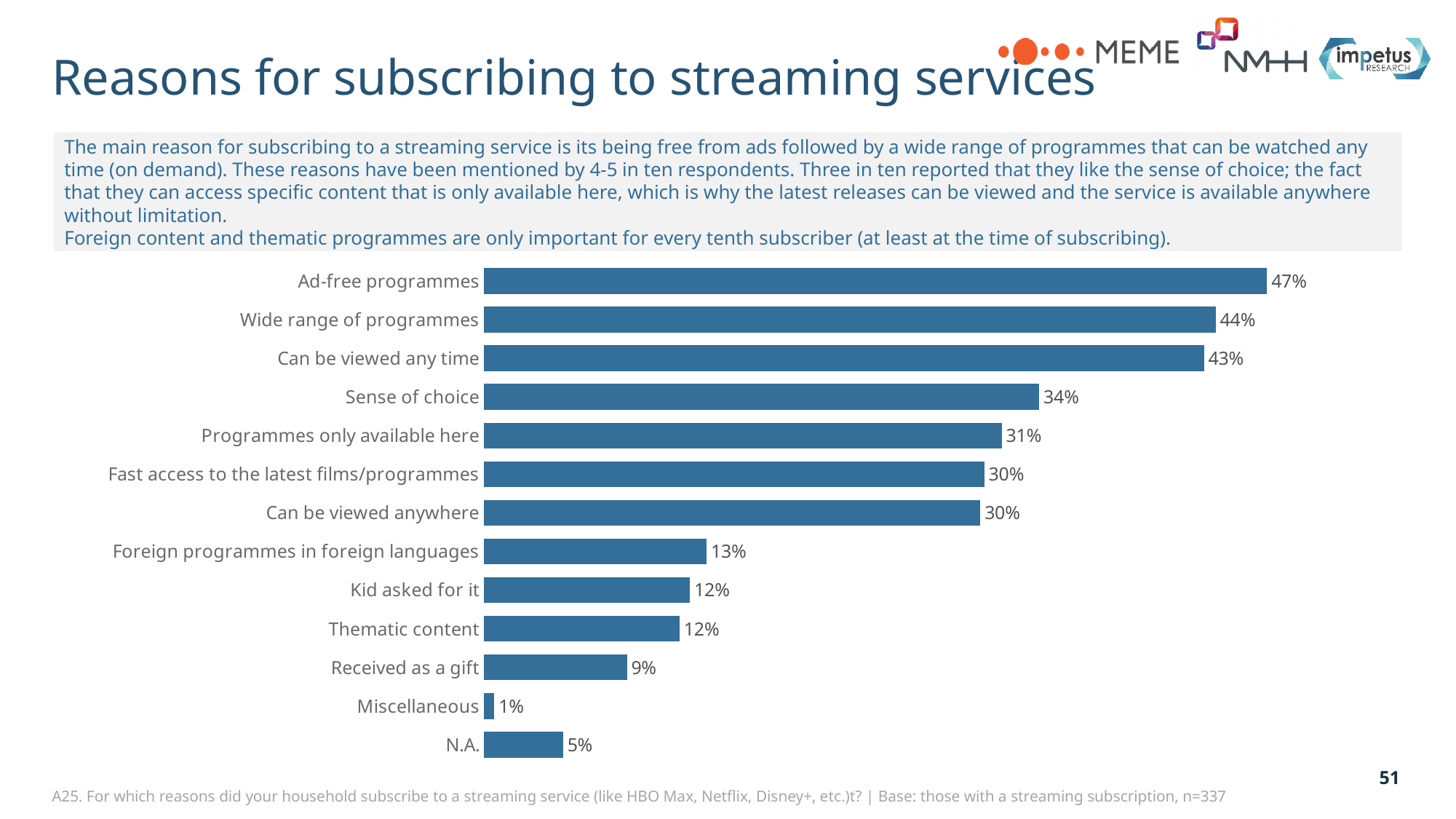
What is the base size (n) stated for the chart? n=337 Which reason has the highest percentage? Ad-free programmes Which is larger: 'Can be viewed any time' or 'Programmes only available here'? Can be viewed any time How many categories are shown in the chart? 13 What percentage is shown for 'Received as a gift'? 9% What is the difference between 'Ad-free programmes' and 'Wide range of programmes'? 3% What percentage of respondents cited 'Ad-free programmes' as a reason for subscribing? 47% Which category has the lowest percentage? Miscellaneous What is the difference between 'Sense of choice' and 'Foreign programmes in foreign languages'? 21% What type of chart is shown on the slide? Bar chart Which is larger: 'N.A.' or 'Received as a gift'? Received as a gift What is the value shown for 'Sense of choice'? 34%